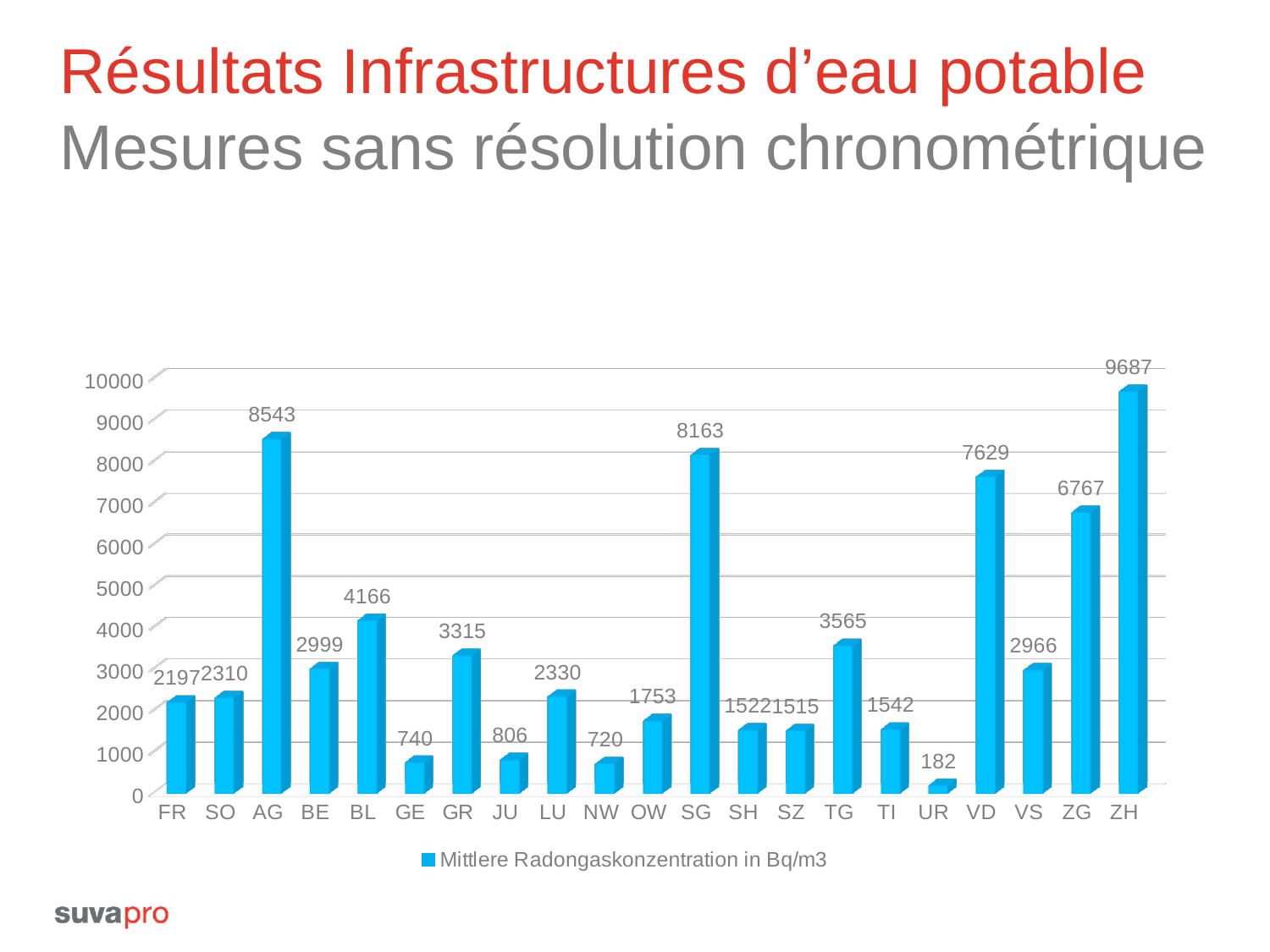
What is the legend entry for the series shown? Mittlere Radongaskonzentration in Bq/m3 What kind of chart is shown on the slide? bar chart What is the difference between the values for ZH and ZG? 2920 What is the value for GE? 740 Which category has the lowest value? UR Which is larger, the value for BL or the value for TG? BL What is the difference between the values for AG and SG? 380 Is the value for VD greater or less than 7000? greater Which category has the highest value? ZH What is the value for VD? 7629 How many categories are shown on the x axis? 21 What is the value for ZH? 9687